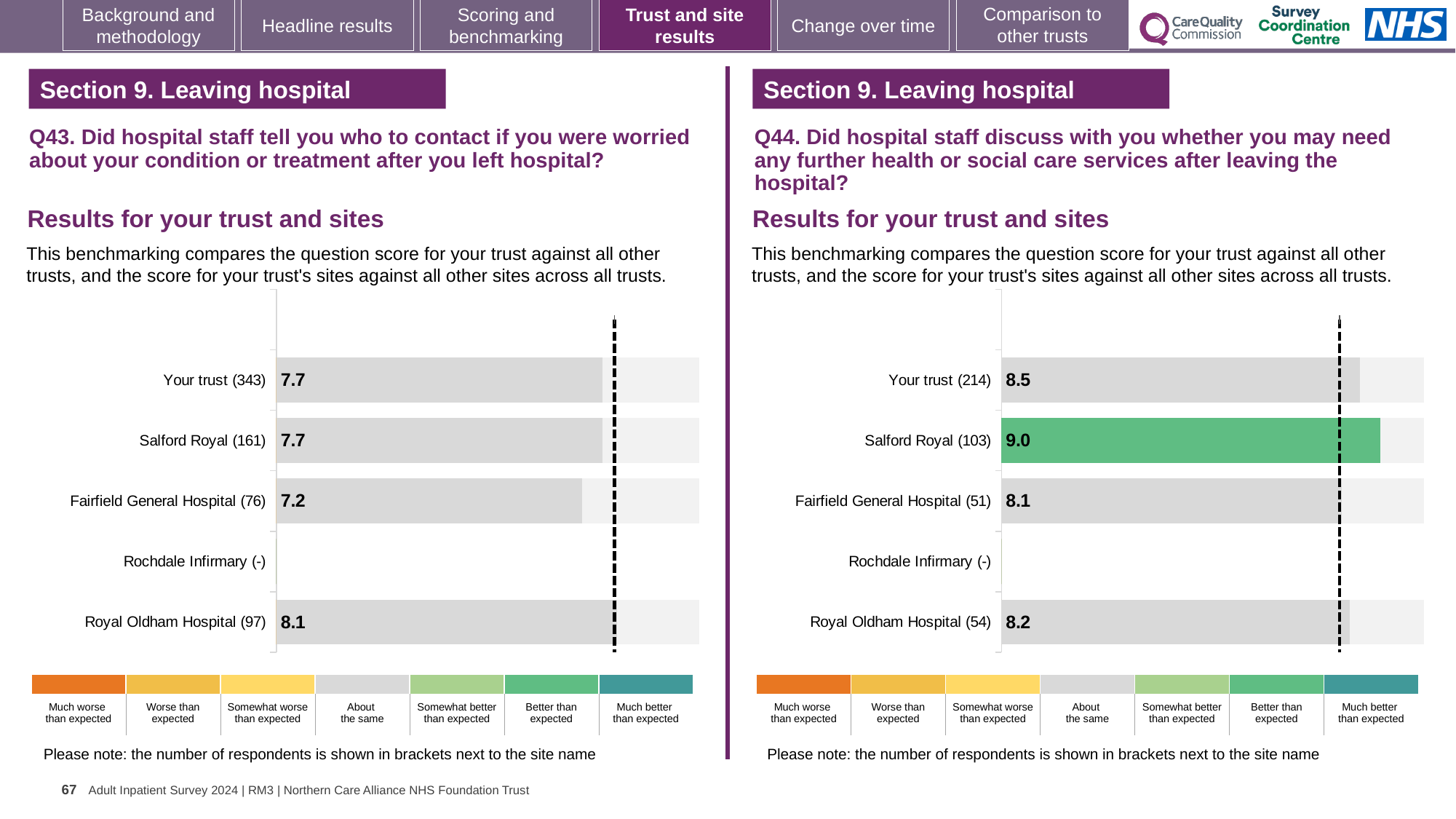
In the Q43 chart (left), what is the score for Fairfield General Hospital? 7.2 In the Q44 chart (right), which site has the lowest score among those with a value shown? Fairfield General Hospital In the Q43 chart (left), how many respondents are shown for Salford Royal? 161 How many site/trust rows are listed in the Q43 chart (left)? 5 In the Q44 chart (right), which site's bar is coloured green rather than grey? Salford Royal In the Q44 chart (right), which is larger: the score for Royal Oldham Hospital or the score for Your trust? Your trust In the Q43 chart (left), what is the difference between the scores for Royal Oldham Hospital and Fairfield General Hospital? 0.9 In the Q43 chart (left), what is the score for Your trust? 7.7 What kind of chart is used on the slide? Bar chart In the Q44 chart (right), what is the score for Salford Royal? 9.0 In the Q44 chart (right), what is the difference between the scores for Salford Royal and Your trust? 0.5 In the Q43 chart (left), which site has the highest score? Royal Oldham Hospital